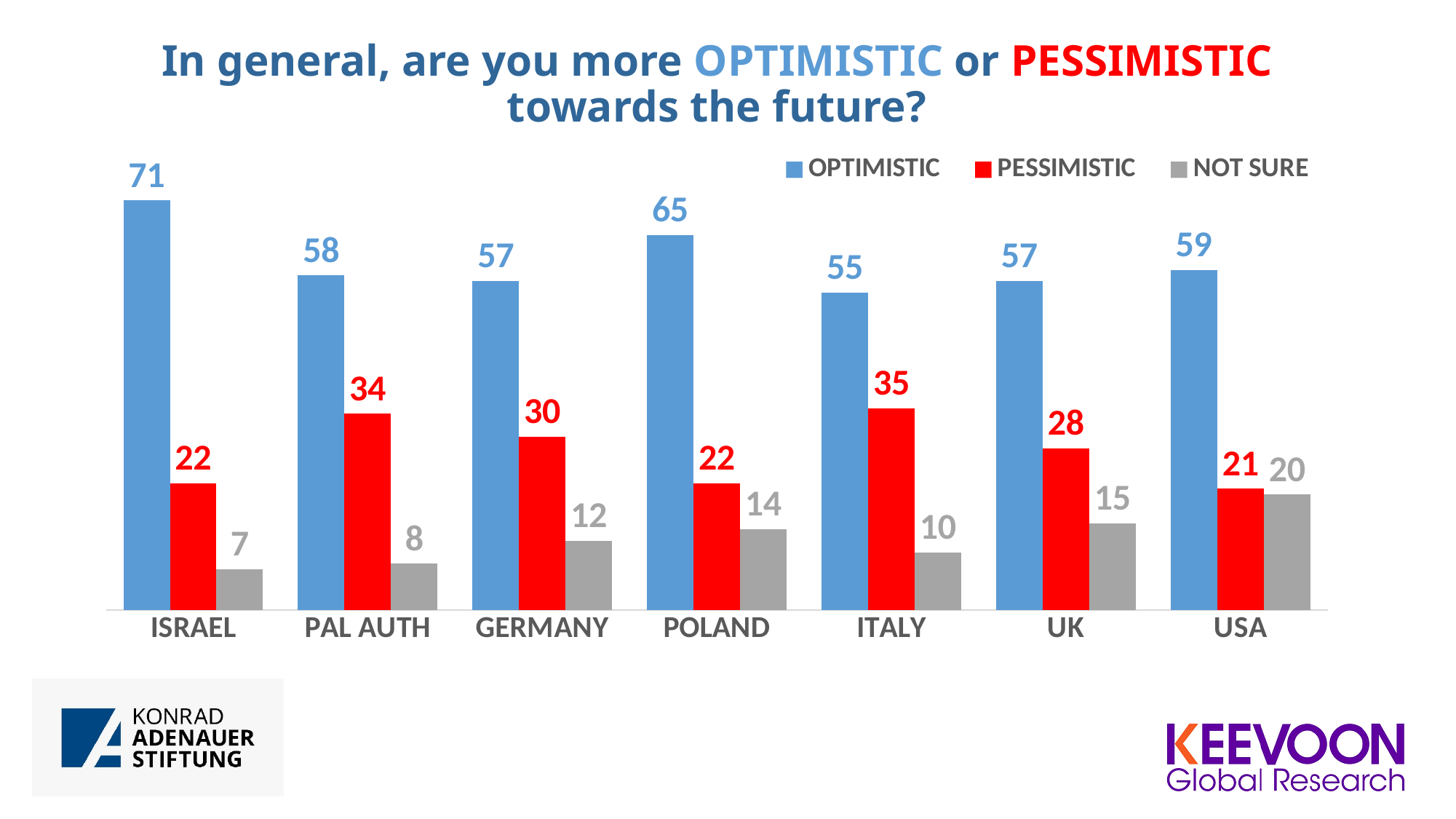
What kind of chart is shown on the slide? Bar chart What is the difference between the OPTIMISTIC and PESSIMISTIC values for POLAND? 43 Which country has the highest PESSIMISTIC value? ITALY What is the PESSIMISTIC value for ITALY? 35 What is the OPTIMISTIC value for ISRAEL? 71 Which country has the highest OPTIMISTIC value? ISRAEL What colour represents the NOT SURE series? Grey How many series does the legend list? 3 What is the NOT SURE value for USA? 20 Which country has the lowest NOT SURE value? ISRAEL How many countries are shown on the x axis? 7 Which is larger, the PESSIMISTIC value for PAL AUTH or the PESSIMISTIC value for UK? PAL AUTH